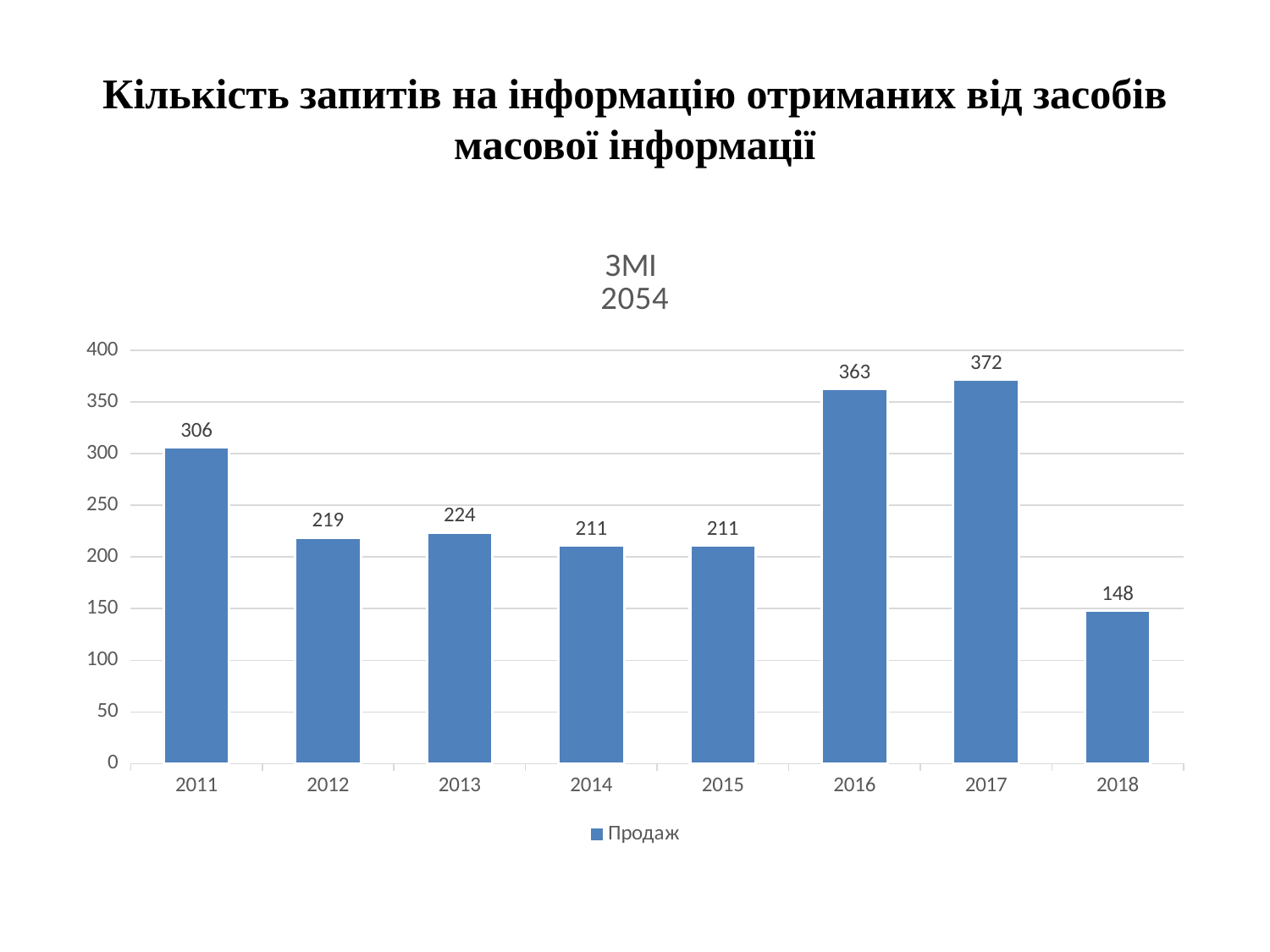
What kind of chart is shown? bar chart What is the value for 2016? 363 What is the legend entry of the chart? Продаж Which is larger, the value for 2011 or the value for 2016? 2016 What is the value for 2018? 148 Which year has the highest value? 2017 Is the value for 2013 greater or less than 200? greater Which year has the lowest value? 2018 What is the value for 2011? 306 What is the difference between the values for 2017 and 2018? 224 How many years are shown on the x axis? 8 How many series does the legend list? 1